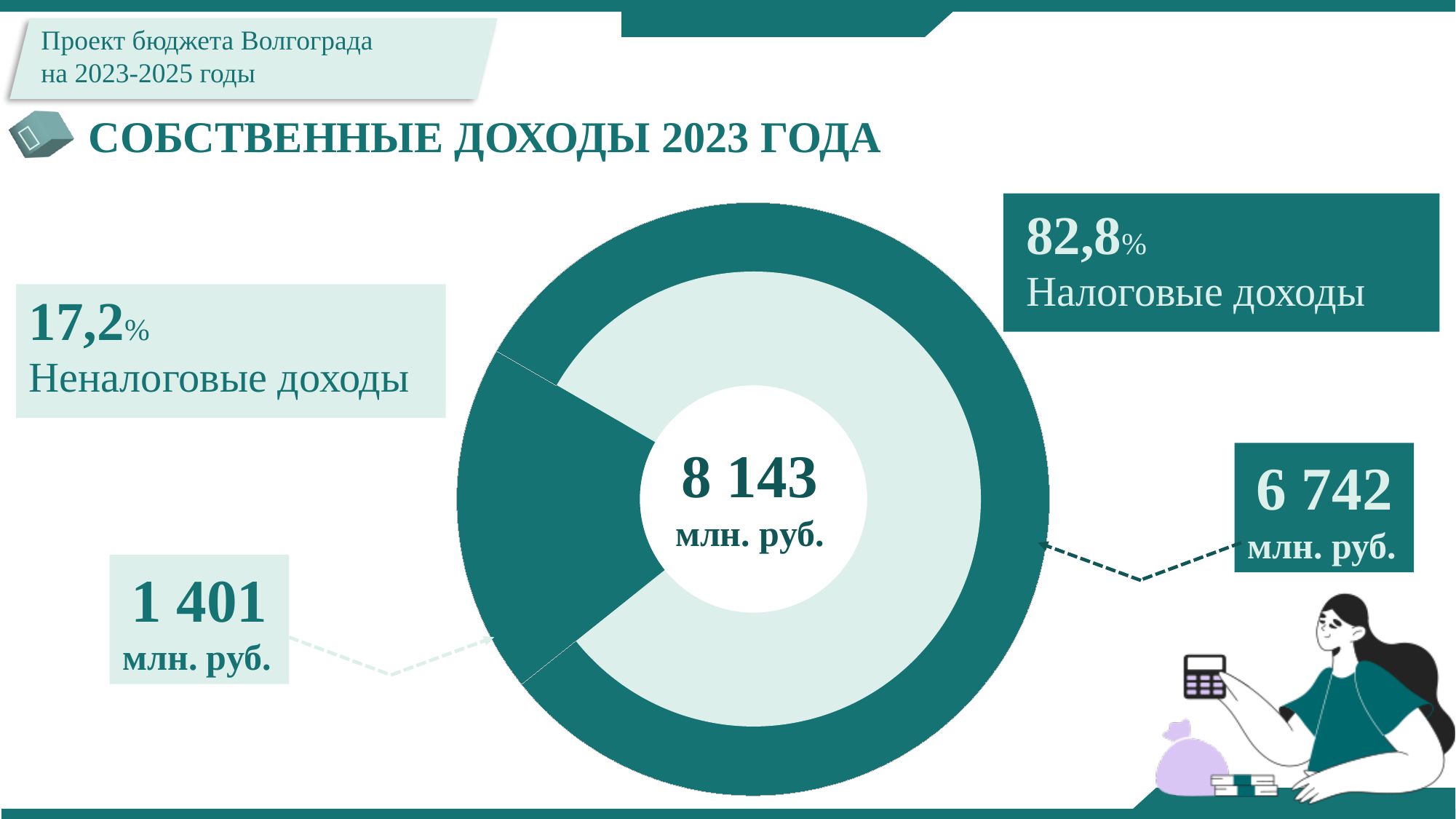
Which category is the largest in the donut chart? Налоговые доходы What is the total of own revenues shown in the centre of the donut chart? 8 143 млн. руб. What is the difference in млн. руб. between Налоговые доходы and Неналоговые доходы? 5 341 млн. руб. What is the title of the slide's chart section? СОБСТВЕННЫЕ ДОХОДЫ 2023 ГОДА What is the value for Налоговые доходы in млн. руб.? 6 742 млн. руб. What kind of chart is shown on the slide? Pie (donut) chart How many categories does the donut chart show? 2 What share of own revenues do Неналоговые доходы make up? 17,2% What share of own revenues do Налоговые доходы make up? 82,8% Which is larger: Налоговые доходы or Неналоговые доходы? Налоговые доходы What is the value for Неналоговые доходы in млн. руб.? 1 401 млн. руб. Which category is the smallest in the donut chart? Неналоговые доходы